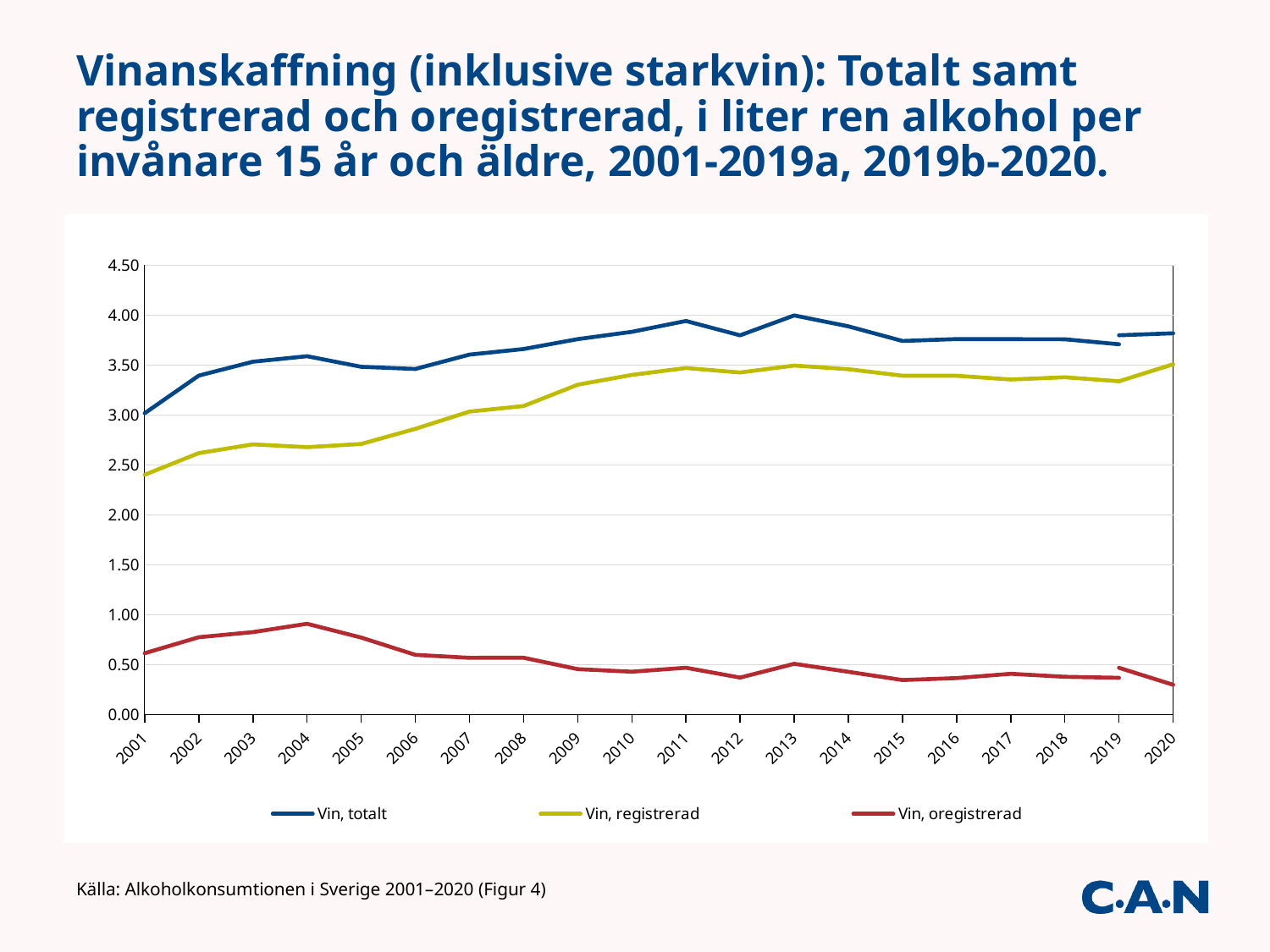
Is the value for Vin, oregistrerad in 2004 greater or less than 0.50? greater In which year is Vin, registrerad at its lowest? 2001 How many years are shown on the x axis? 20 Is the value for Vin, totalt in 2001 greater or less than 3.50? less In which year is Vin, oregistrerad at its highest? 2004 How many series does the legend list? 3 Is the value for Vin, totalt in 2013 greater or less than 3.50? greater Which is larger for Vin, registrerad: the value in 2001 or the value in 2020? 2020 Does Vin, oregistrerad rise or fall from 2004 to 2020? fall What kind of chart is shown on the slide? Line chart